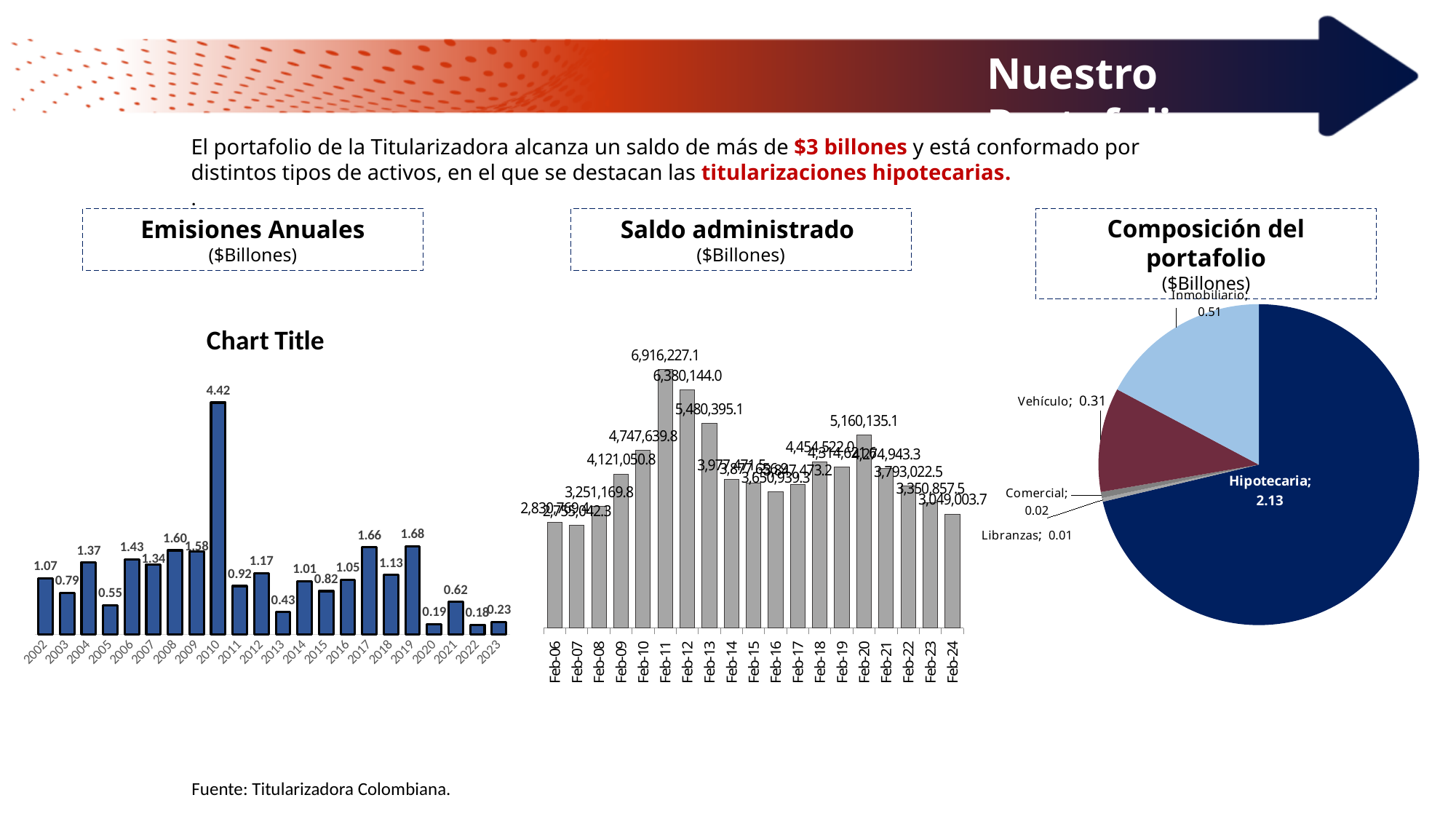
In the Emisiones Anuales chart, what is the difference between the values for 2019 and 2020? 1.49 In the Emisiones Anuales chart, which is larger, the value for 2008 or the value for 2012? 2008 In the Saldo administrado chart, how many periods are plotted? 19 In the Composición del portafolio chart, what is the value for Vehículo? 0.31 In the Emisiones Anuales chart, what is the value for 2010? 4.42 In the Emisiones Anuales chart, which year has the lowest value? 2022 In the Emisiones Anuales chart, how many years are plotted? 22 What kind of chart is the Composición del portafolio chart? Pie chart In the Saldo administrado chart, which period has the highest value? Feb-11 In the Saldo administrado chart, what is the value for Feb-24? 3,049,003.7 In the Saldo administrado chart, what is the value for Feb-11? 6,916,227.1 In the Composición del portafolio chart, which category has the largest slice? Hipotecaria